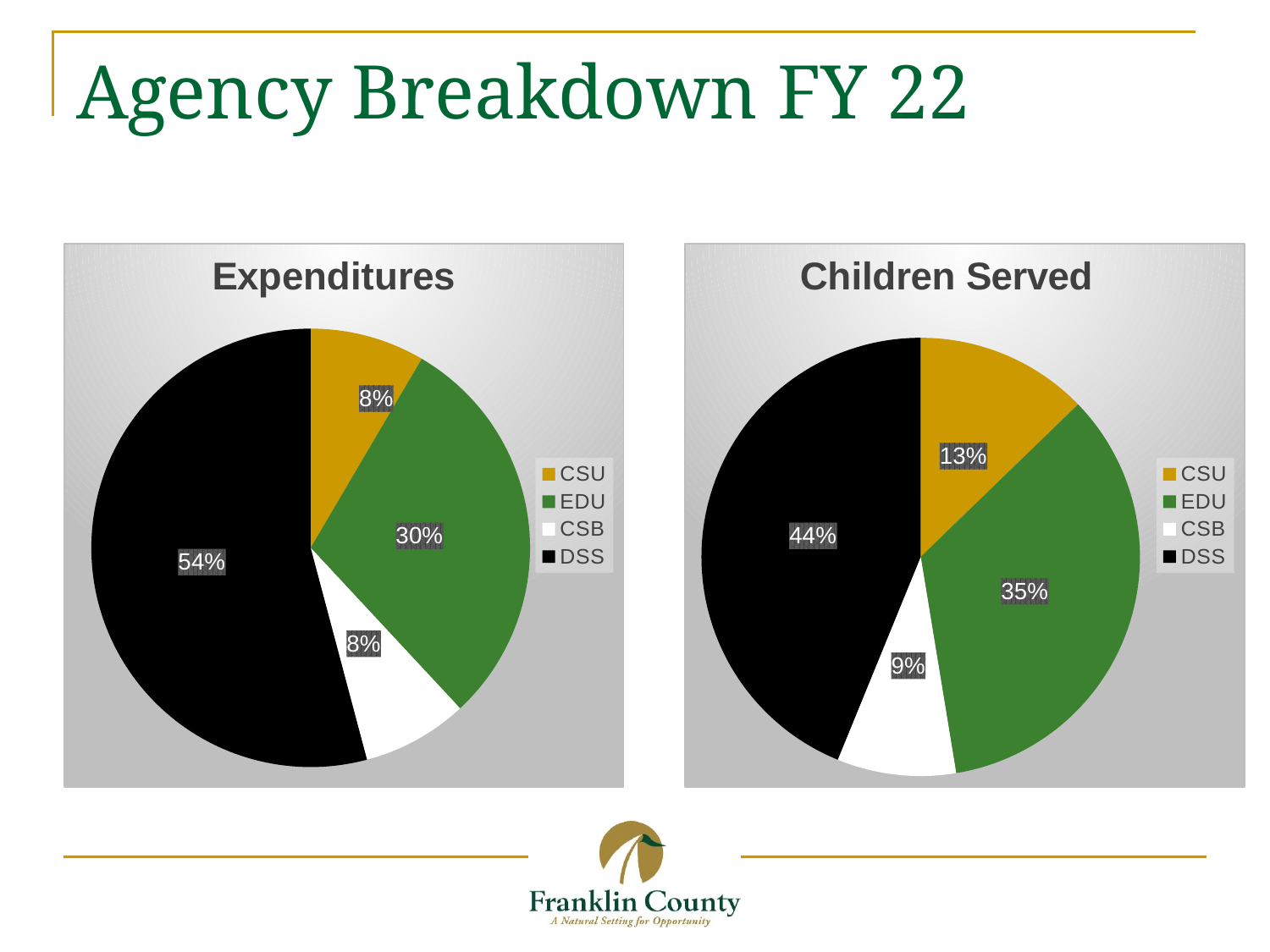
In the Children Served chart, what share does CSU have? 13% In the Expenditures chart, what share does DSS have? 54% In the Children Served chart, what is the difference between the DSS share and the EDU share? 9% In the Children Served chart, what share does CSB have? 9% In the Children Served chart, which agency has the largest share? DSS In the Expenditures chart, what share does EDU have? 30% In the Children Served chart, which is larger, the EDU share or the CSU share? EDU How many entries does the legend of the Expenditures chart list? 4 In the Children Served chart, which agency has the smallest share? CSB What kind of chart is the Children Served chart? Pie chart In the Expenditures chart, what is the difference between the DSS share and the EDU share? 24% In the Expenditures chart, which agency has the largest share? DSS